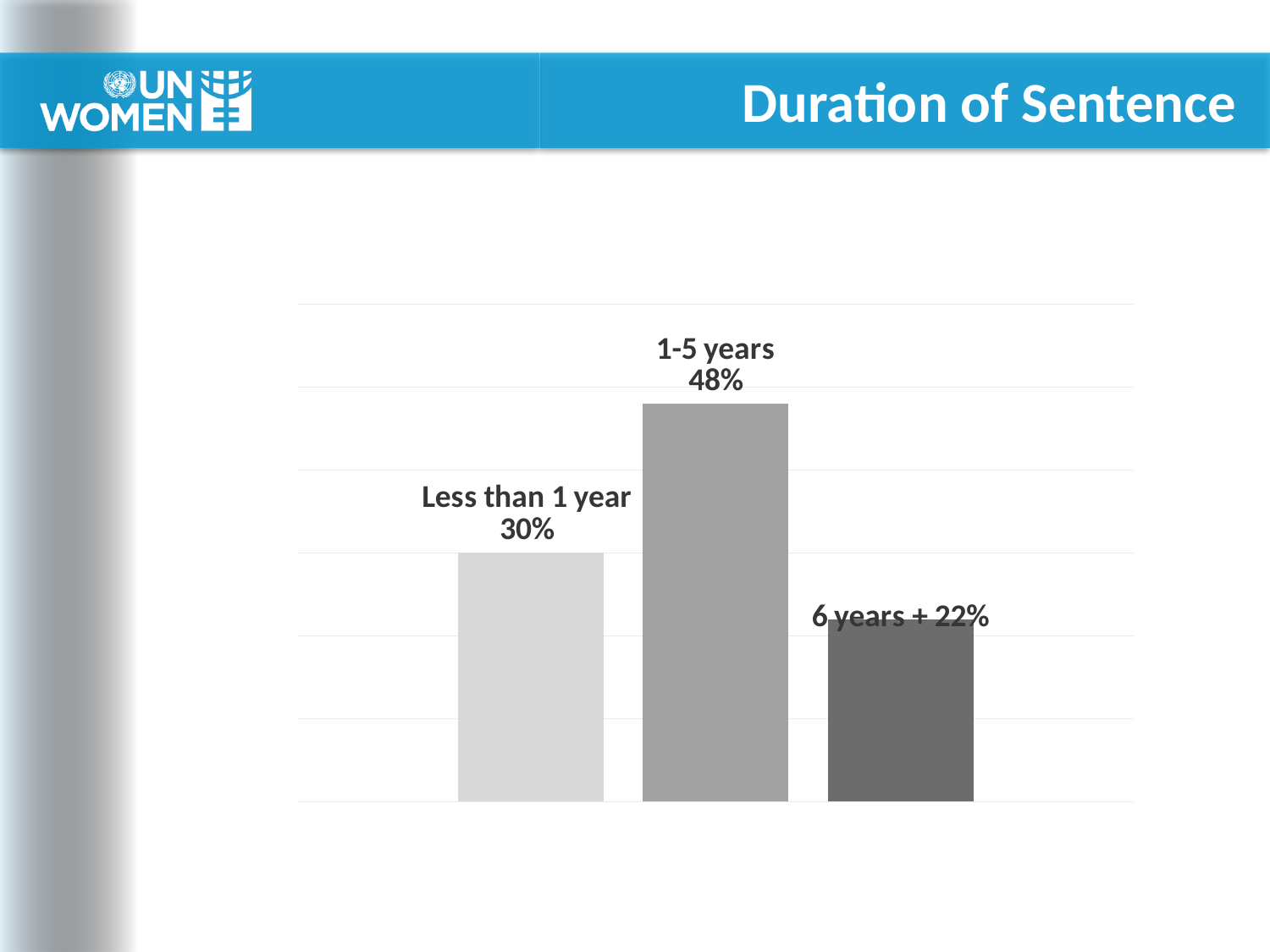
What is the difference in percentage points between the less than 1 year and 6 years + categories? 8 What percentage of sentences are for less than 1 year? 30% Which is larger, the percentage for less than 1 year or for 6 years +? Less than 1 year What percentage of sentences are for 6 years or more? 22% What is the title of the slide containing the chart? Duration of Sentence What percentage of sentences are for 1-5 years? 48% What is the total of the three percentages shown in the chart? 100% How many sentence duration categories are shown in the chart? 3 Which sentence duration category has the highest percentage? 1-5 years What is the difference in percentage points between the 1-5 years and less than 1 year categories? 18 Which sentence duration category has the lowest percentage? 6 years + What kind of chart is shown on the slide? Bar chart